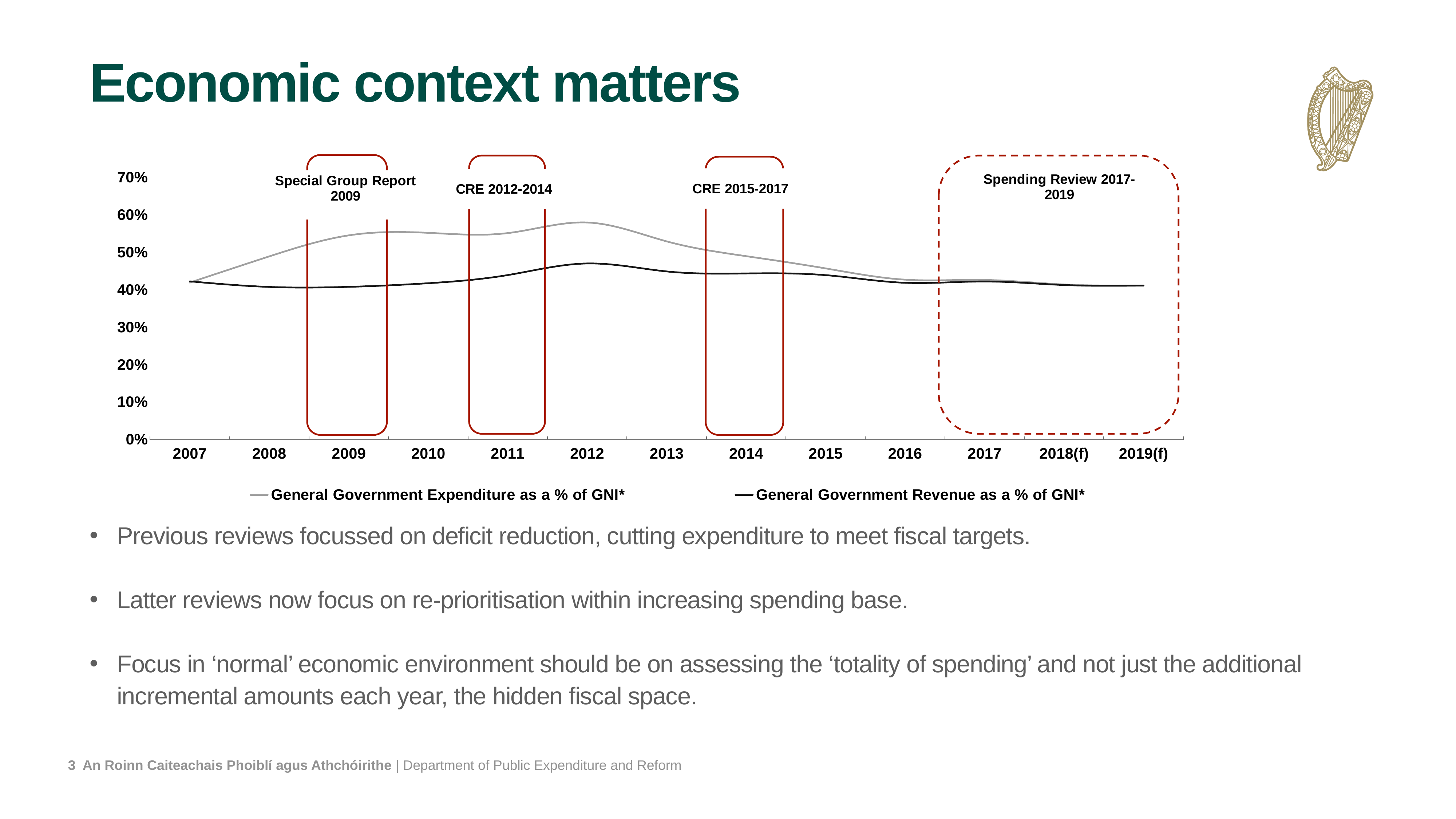
What kind of chart is shown on the slide? Line chart How many series does the chart legend list? 2 Does General Government Expenditure as a % of GNI* rise or fall between 2012 and 2016? Fall What label is shown in the dashed box covering 2017 to 2019(f) on the chart? Spending Review 2017-2019 Which series is drawn with the grey line in the chart? General Government Expenditure as a % of GNI* How many years are shown along the x axis of the chart? 13 In which year does General Government Revenue as a % of GNI* reach its highest value? 2012 Is the value for General Government Expenditure as a % of GNI* in 2019(f) greater or less than 50%? less Is the value for General Government Revenue as a % of GNI* in 2012 greater or less than 50%? less In which year does General Government Expenditure as a % of GNI* reach its highest value? 2012 Is the value for General Government Expenditure as a % of GNI* in 2012 greater or less than 50%? greater In 2012, which is larger: General Government Expenditure as a % of GNI* or General Government Revenue as a % of GNI*? General Government Expenditure as a % of GNI*